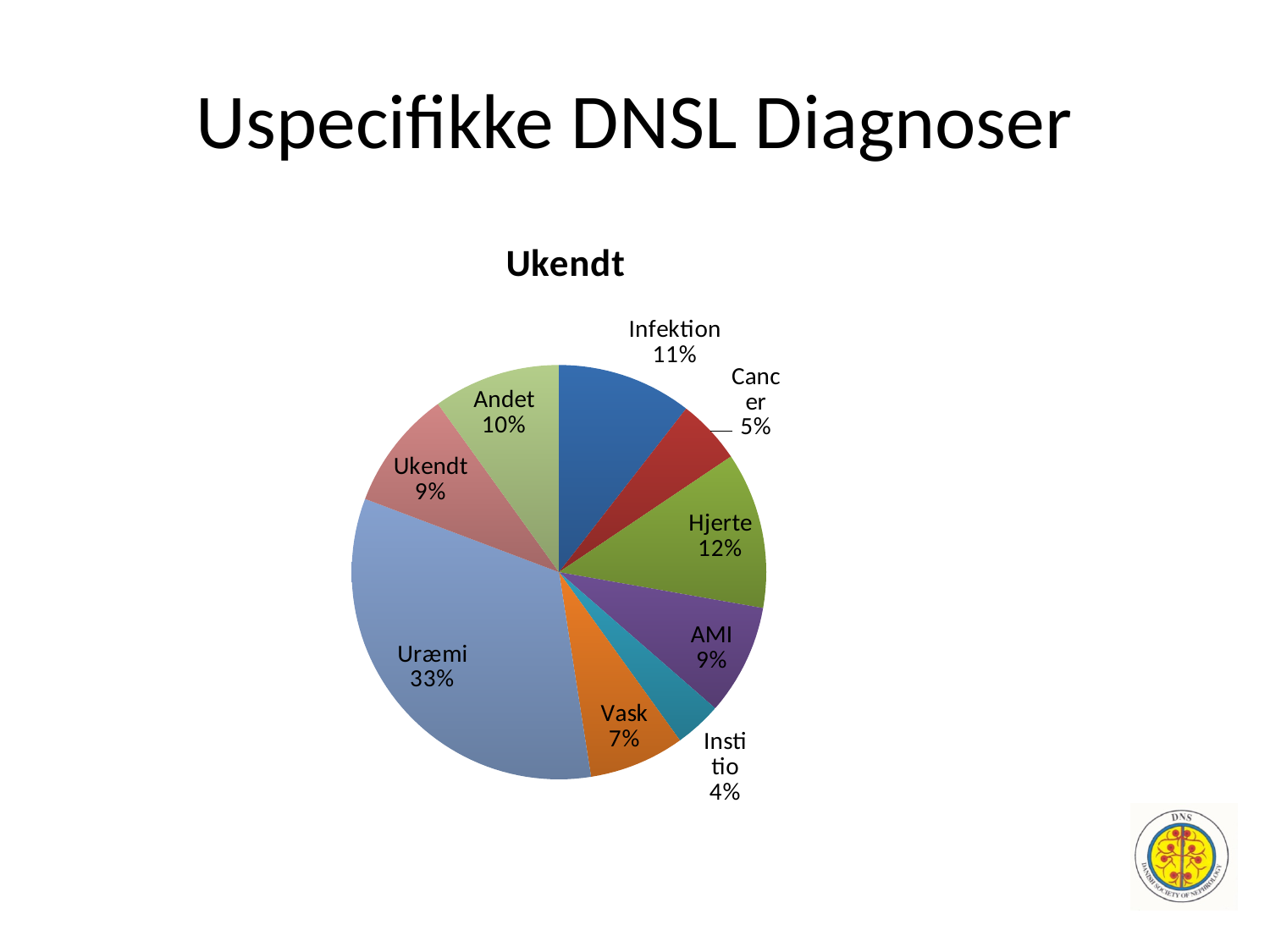
What is the difference between the Infektion share and the Cancer share? 6% What share of the pie does Andet have? 10% How many slices does the pie chart have? 9 What share of the pie does Uræmi have? 33% What kind of chart is shown on the slide? pie chart What is the difference between the Uræmi share and the Hjerte share? 21% What share of the pie does Institio have? 4% Which is larger, the Infektion slice or the Vask slice? Infektion Which slice is the largest? Uræmi What is the chart's title? Ukendt Which slice is the smallest? Institio